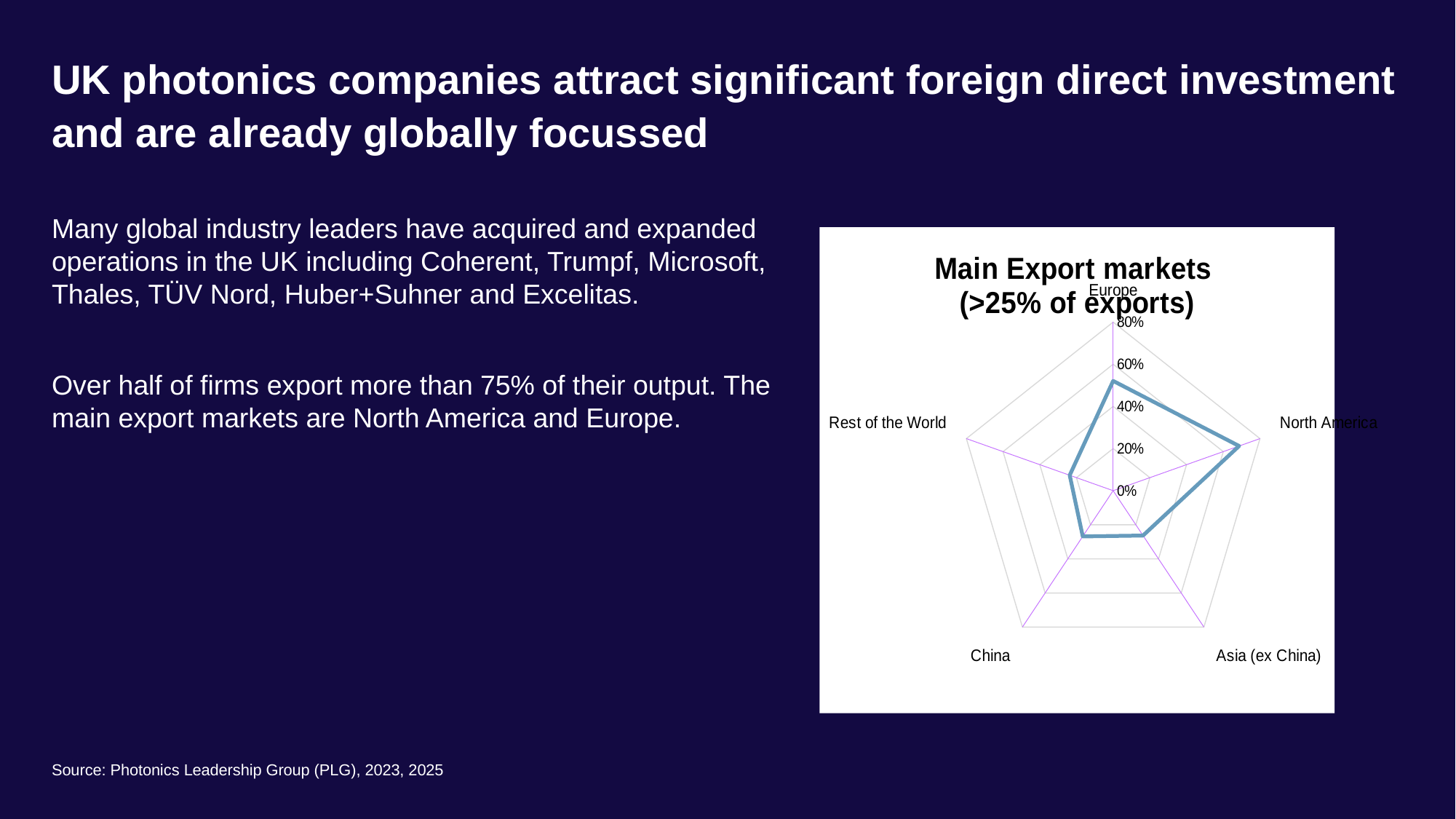
Which has the larger value, Europe or North America? North America Which export market has the highest value on the chart? North America Is the value for Rest of the World greater or less than 40%? less Is the value for Asia (ex China) greater or less than 40%? less What is the title of the chart? Main Export markets (>25% of exports) Is the value for China greater or less than 40%? less What kind of chart is shown on the slide? Radar chart How many export market categories are plotted on the radar chart? 5 Which has the larger value, Europe or China? Europe